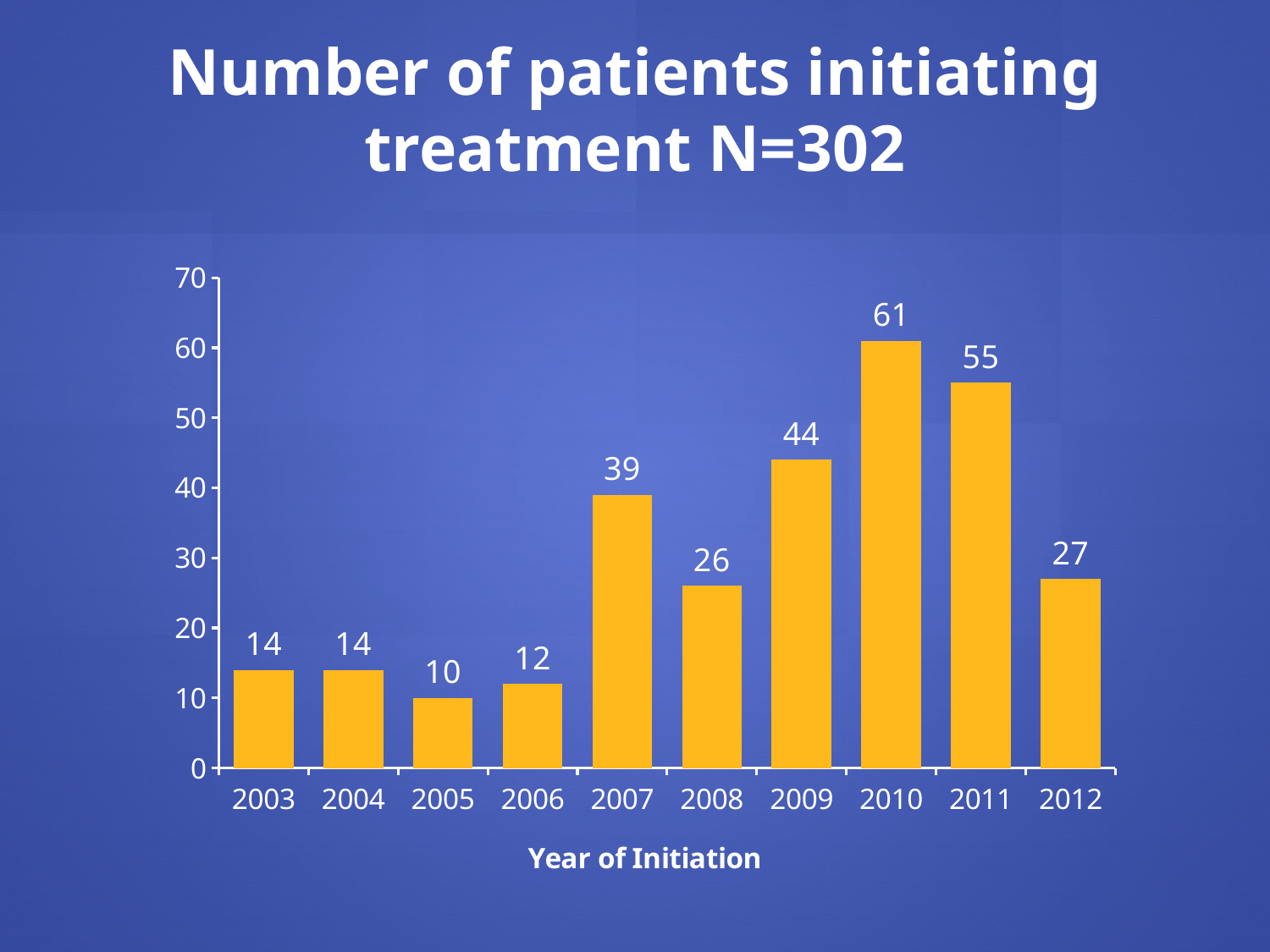
Which year has the lowest number of patients initiating treatment? 2005 What is the difference between the values for 2010 and 2011? 6 How many patients initiated treatment in 2010? 61 Which year has a larger value, 2007 or 2012? 2007 What is the difference between the values for 2009 and 2008? 18 What kind of chart is shown on the slide? Bar chart What is the label of the x axis? Year of Initiation Is the value for 2011 greater or less than 50? greater Which year has the highest number of patients initiating treatment? 2010 How many years are shown on the x axis? 10 What is the value shown for 2007? 39 Do the values rise or fall from 2008 to 2010? Rise